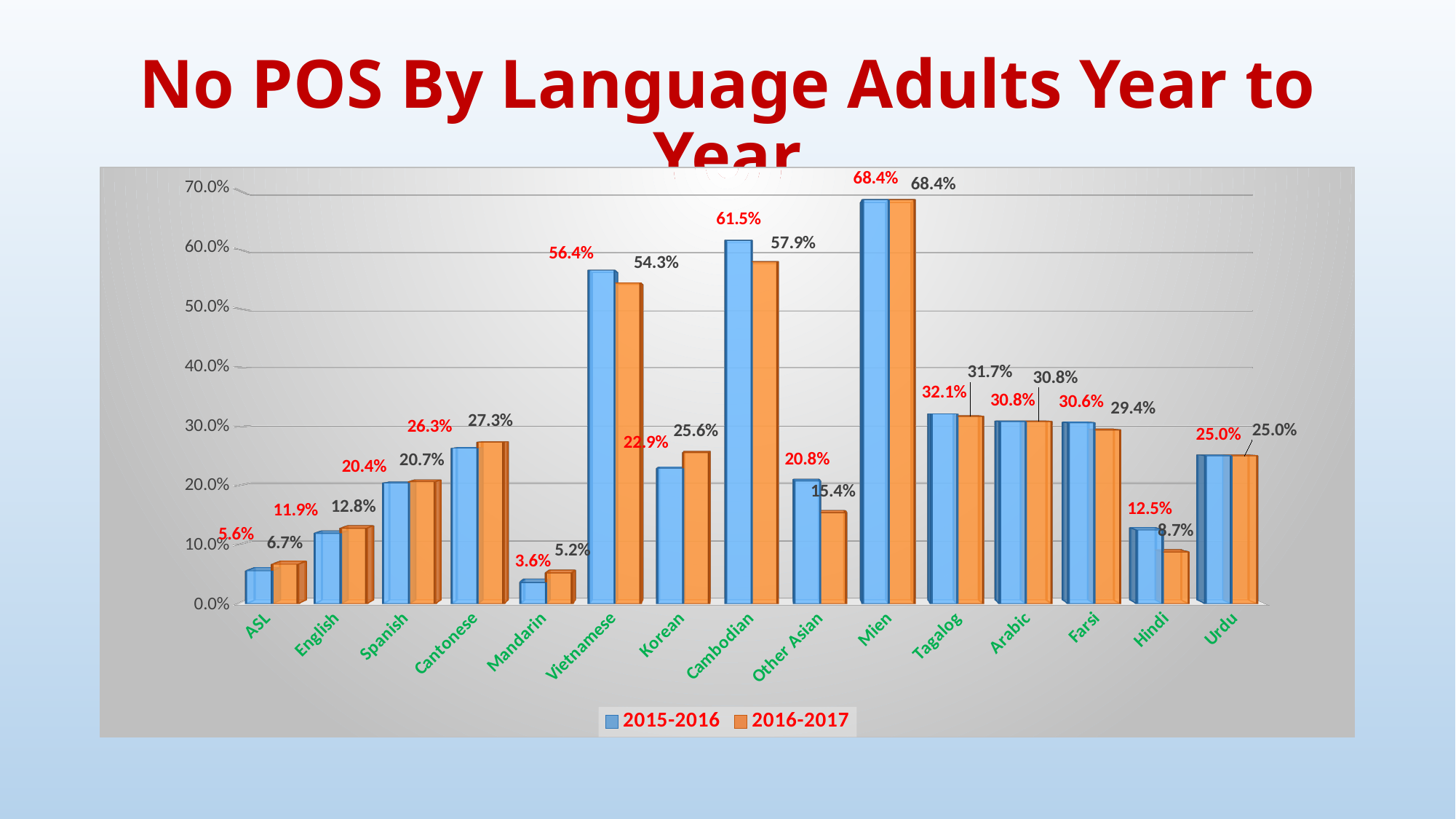
Which language has the highest 2015-2016 value? Mien How many languages are shown on the x axis? 15 What is the 2015-2016 value for Cambodian? 61.5% What is the 2016-2017 value for Other Asian? 15.4% What is the 2016-2017 value for Hindi? 8.7% Which is larger for Hindi: the 2015-2016 value or the 2016-2017 value? 2015-2016 How many series does the legend list? 2 What is the difference between the 2015-2016 and 2016-2017 values for Cambodian? 3.6% What kind of chart is shown on the slide? Bar chart What is the 2015-2016 value for Korean? 22.9% What is the difference between the 2016-2017 values for Vietnamese and Korean? 28.7% Which language has the lowest 2016-2017 value? Mandarin